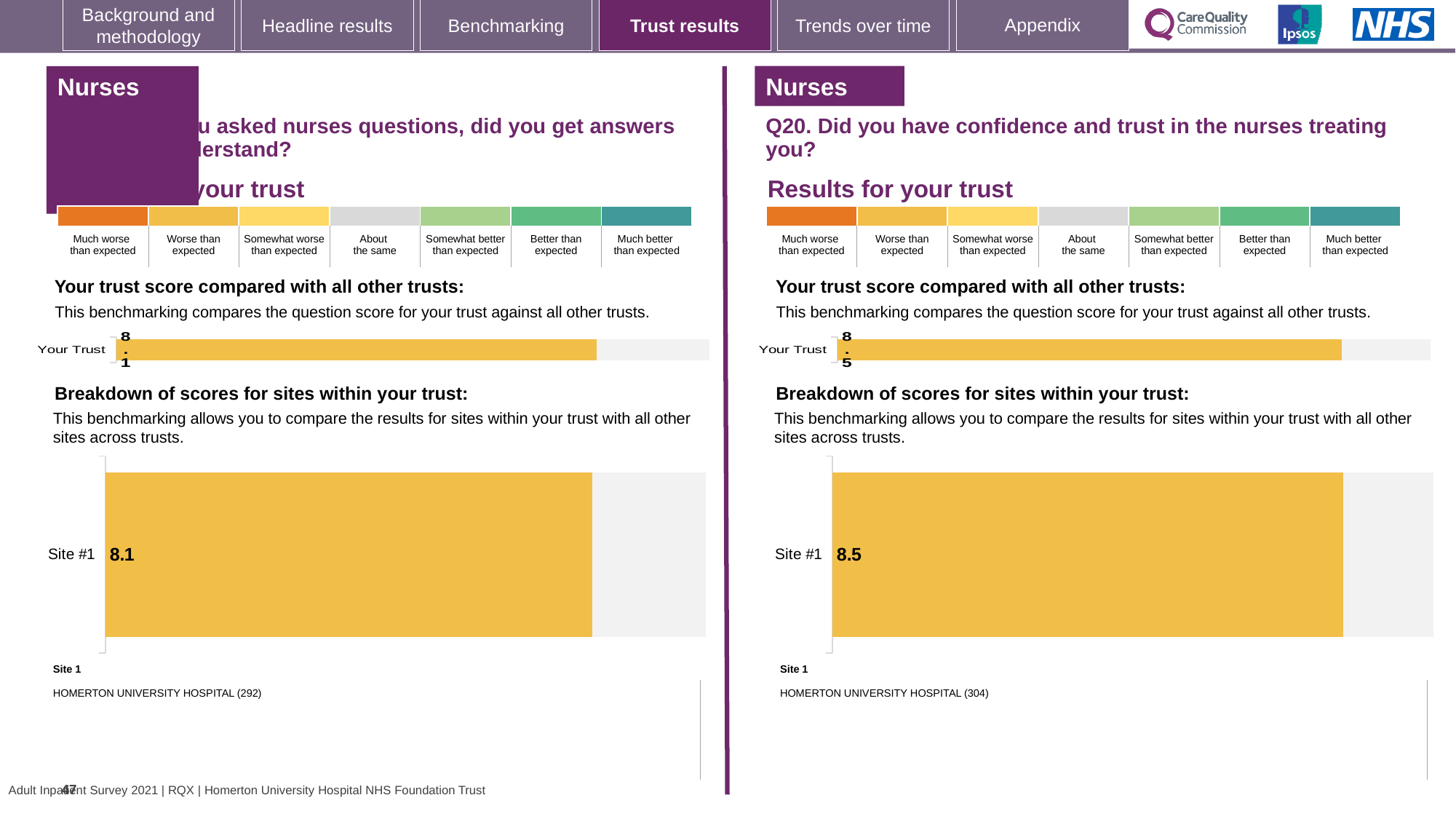
On the right-hand chart (Q20), what is the score for Site #1? 8.5 How many sites are shown in the site breakdown chart on the right-hand side (Q20)? 1 What kind of chart is used to show the Site #1 score on the right-hand side (Q20)? Bar chart On the right-hand chart (Q20, confidence and trust in nurses), what is the score for Your Trust? 8.5 On the left-hand chart, what is the score for Site #1? 8.1 On the left-hand chart, which site is listed as Site 1? HOMERTON UNIVERSITY HOSPITAL (292) On the left-hand chart, what is the score for Your Trust? 8.1 On the right-hand chart (Q20), which site is listed as Site 1? HOMERTON UNIVERSITY HOSPITAL (304) Which is larger: the Your Trust score on the left-hand chart or the Your Trust score on the right-hand chart (Q20)? Right-hand chart (Q20) What is the difference between the Site #1 score on the right-hand chart (Q20) and the Site #1 score on the left-hand chart? 0.4 How many sites are shown in the site breakdown chart on the left-hand side? 1